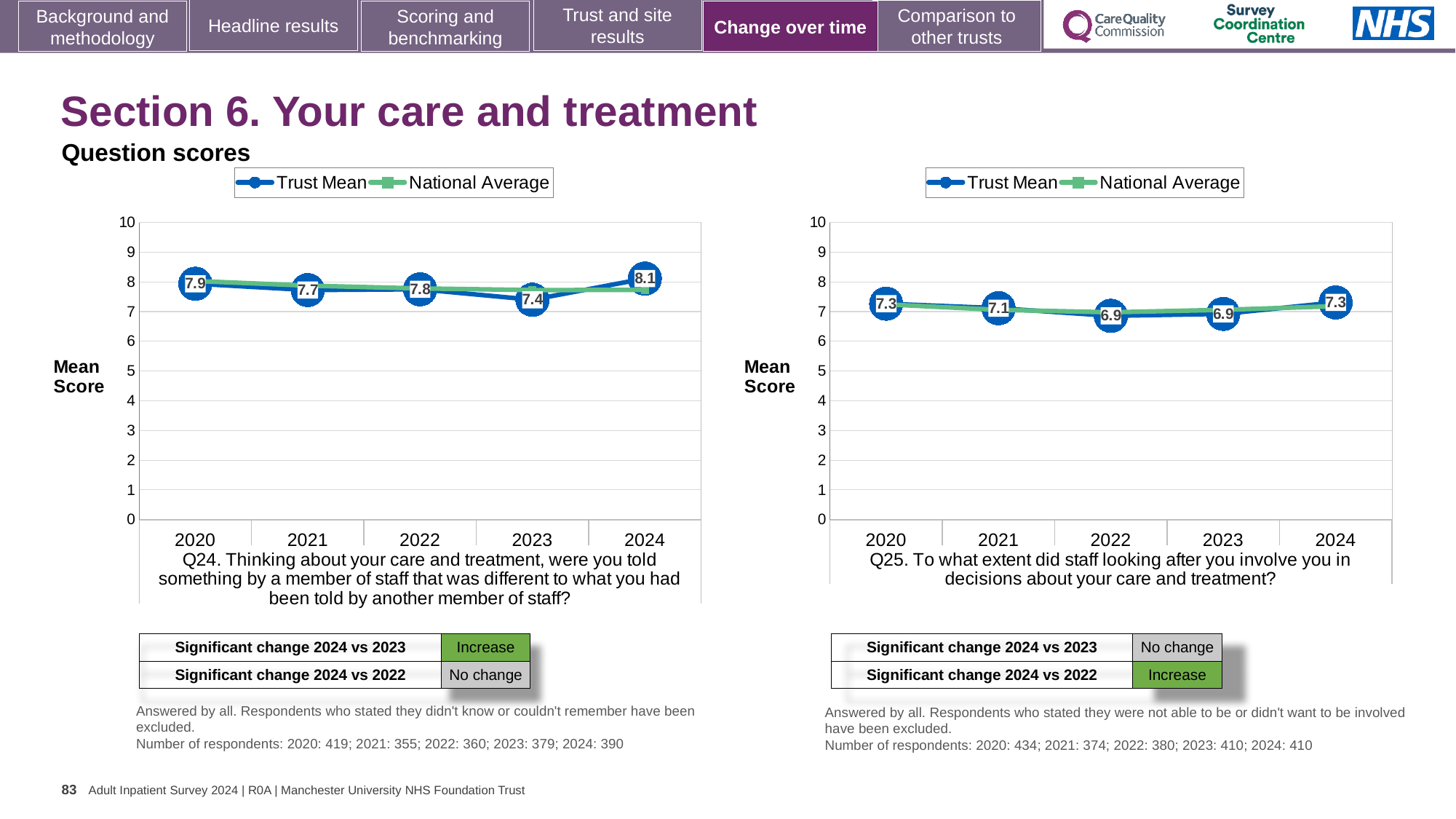
How many years are shown on the x axis of the Q24 chart (left)? 5 In the Q25 chart (right), is the Trust Mean value for 2022 greater or less than 8? less How many series does the legend of the Q25 chart (right) list? 2 In the Q25 chart (right), what is the Trust Mean score for 2021? 7.1 In the Q24 chart (left), what is the difference between the Trust Mean scores for 2024 and 2023? 0.7 In the Q25 chart (right), what is the difference between the Trust Mean scores for 2020 and 2022? 0.4 In the Q24 chart (left), what is the Trust Mean score for 2024? 8.1 In the Q24 chart (left), which year has the highest Trust Mean score? 2024 In the Q25 chart (right), is the Trust Mean score higher in 2021 or in 2022? 2021 In the Q24 chart (left), which year has the lowest Trust Mean score? 2023 In the Q25 chart (right), what is the Trust Mean score for 2020? 7.3 In the Q24 chart (left), what is the Trust Mean score for 2023? 7.4